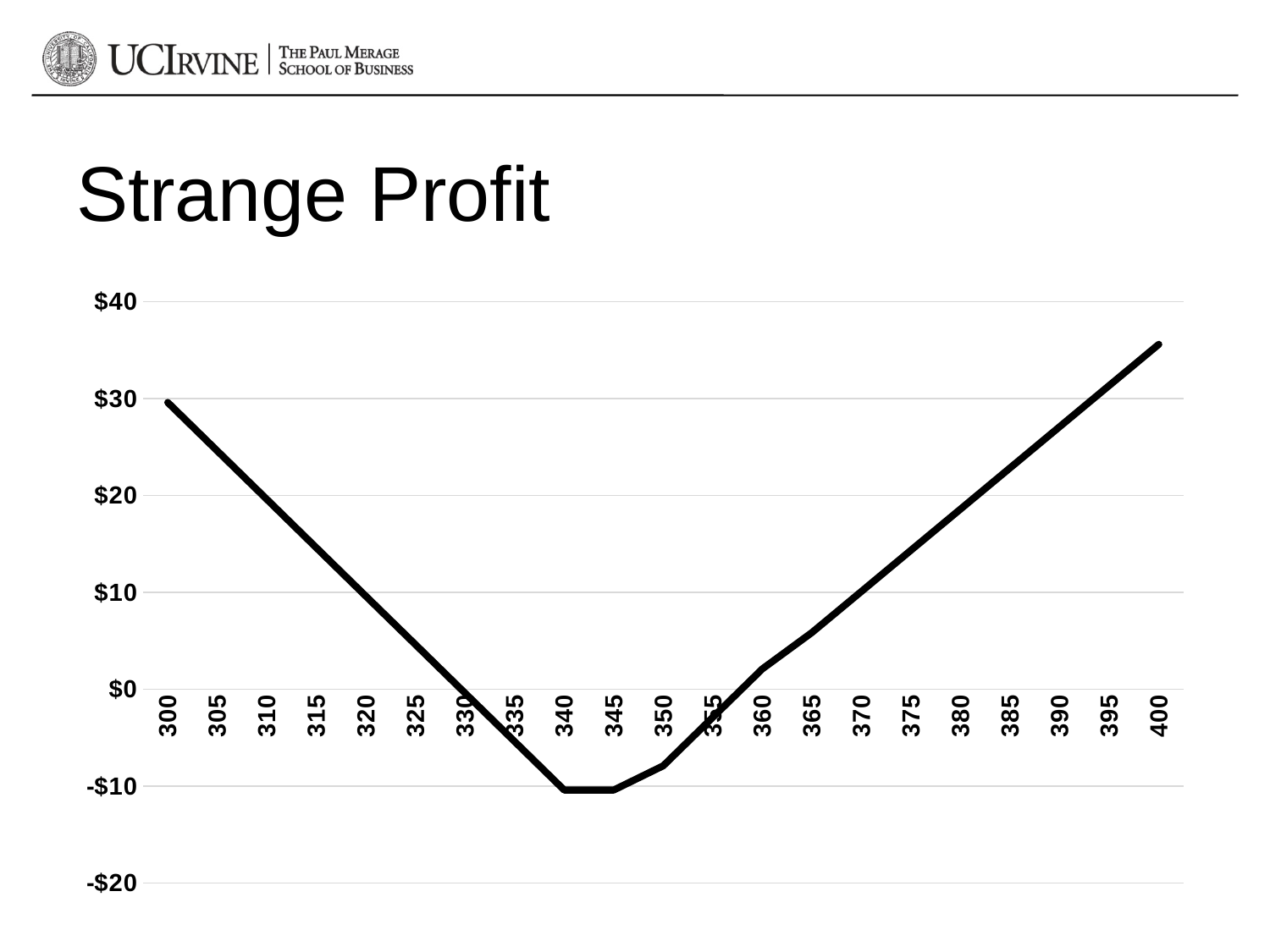
Is the value at 300 greater or less than $20? greater What is the title of the chart? Strange Profit How many points are labelled along the x axis of the chart? 21 Does the line rise or fall as the x axis goes from 300 to 340? fall Which has the larger value, 300 or 400? 400 Is the value at 335 greater or less than $0? less Is the value at 340 greater or less than $0? less What kind of chart is shown on the slide? line chart At which x-axis value is the plotted line highest? 400 Does the line rise or fall as the x axis goes from 350 to 400? rise